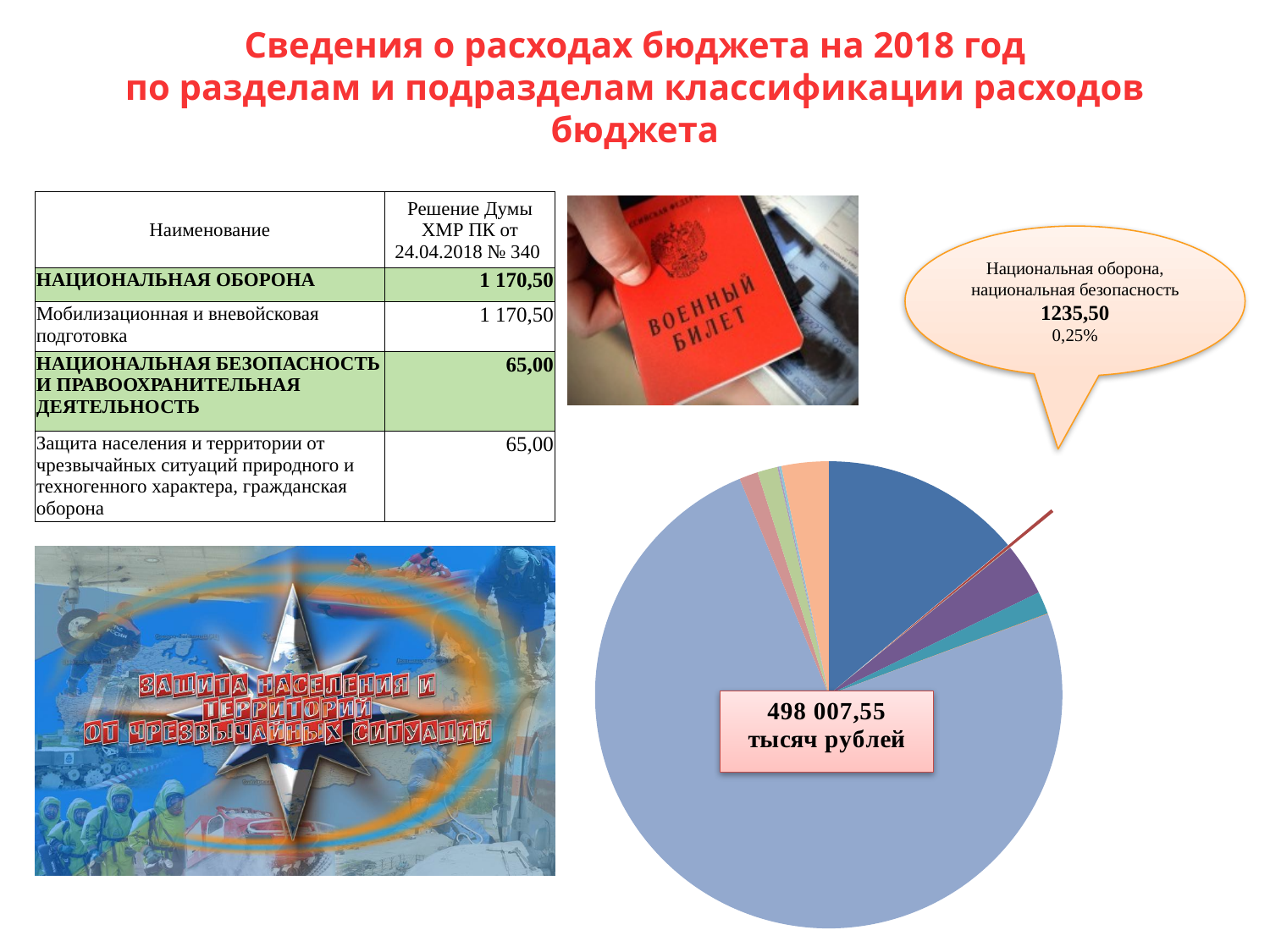
Does the largest slice of the pie chart cover more or less than half of the pie? more What total value is printed in the centre of the pie chart? 498 007,55 тысяч рублей Is the share for Национальная оборона, национальная безопасность in the pie chart greater or less than 1%? less According to the callout on the pie chart, what share of the pie does Национальная оборона, национальная безопасность represent? 0,25% Does the pie chart display a legend? No What kind of chart is shown on the slide? pie chart According to the callout on the pie chart, what is the value for Национальная оборона, национальная безопасность? 1235,50 What colour is the largest slice of the pie chart? light blue